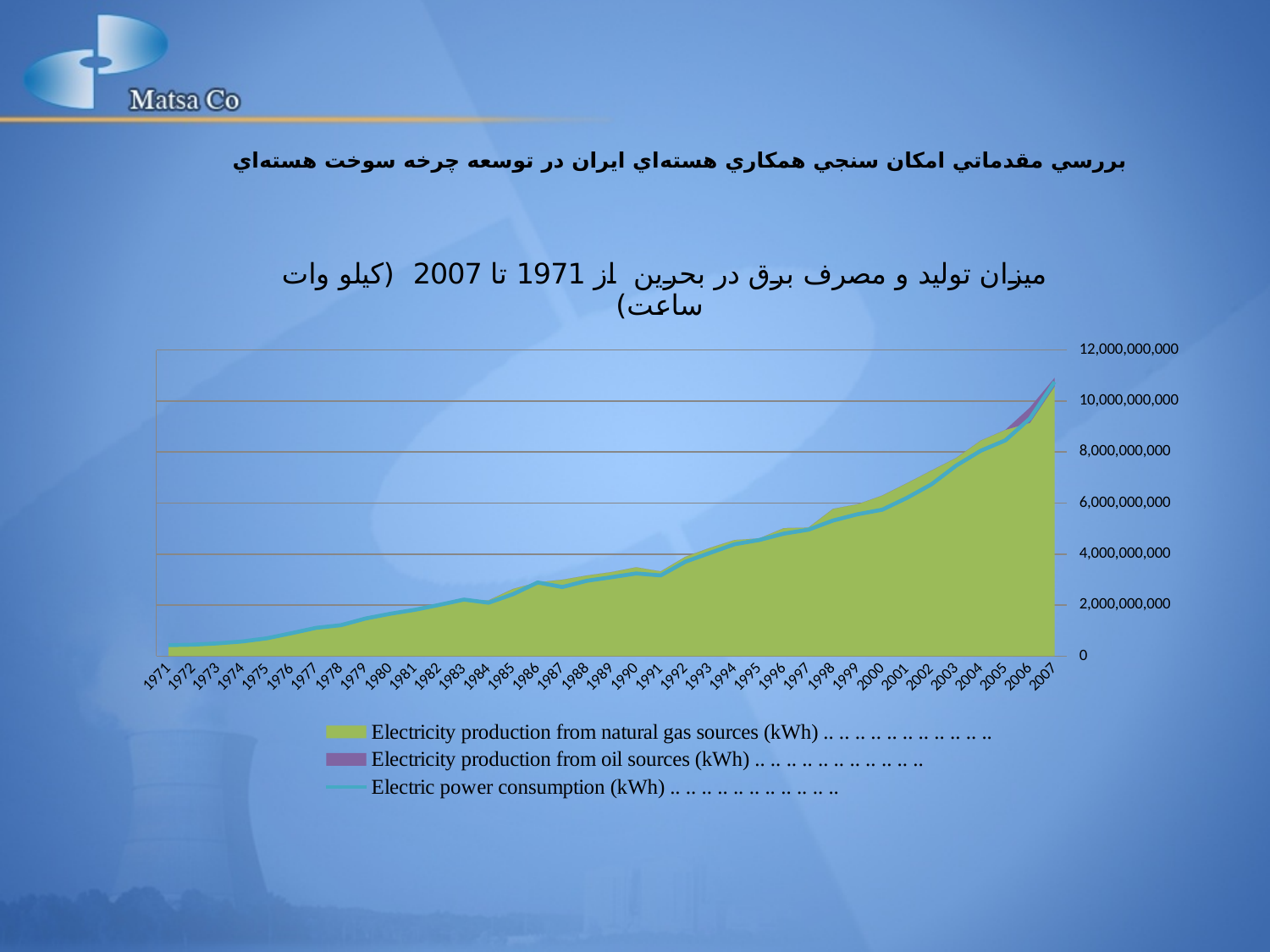
What is the first year shown on the x axis? 1971 How many years are plotted along the x axis? 37 Is the value for Electric power consumption (kWh) in 1990 greater or less than 4,000,000,000? less What is the highest value shown on the y axis? 12,000,000,000 Do the values for Electric power consumption (kWh) generally rise or fall from 1971 to 2007? rise Is the value for Electric power consumption (kWh) in 2007 greater or less than 10,000,000,000? greater In which year is Electricity production from natural gas sources (kWh) lowest? 1971 What kind of chart is shown on the slide? area and line chart Is the value for Electricity production from natural gas sources (kWh) in 1971 greater or less than 2,000,000,000? less How many series does the legend list? 3 In which year is Electric power consumption (kWh) highest? 2007